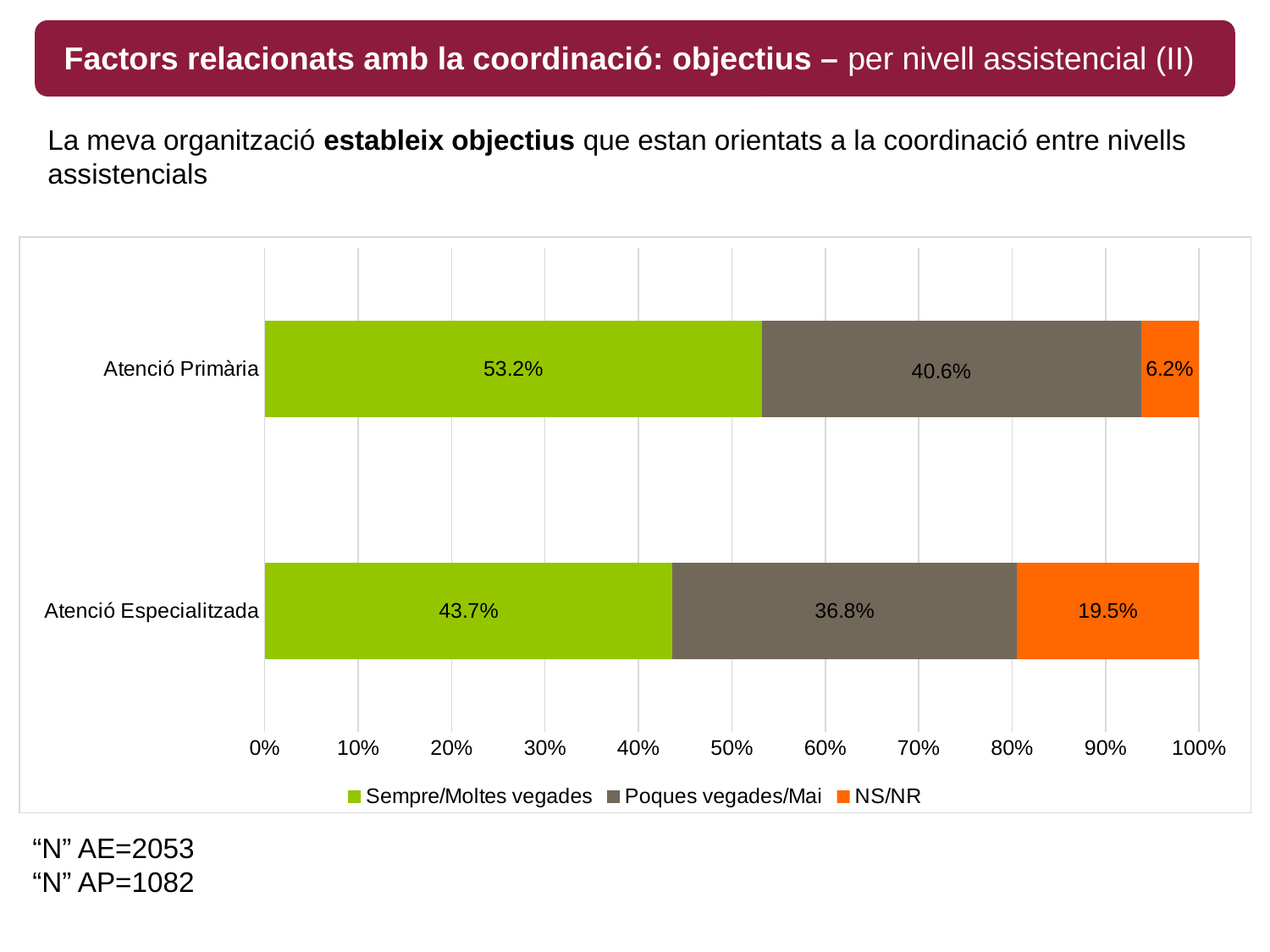
How many categories are shown on the chart? 2 What is the NS/NR value for Atenció Primària? 6.2% What is the value for Poques vegades/Mai for Atenció Especialitzada? 36.8% What is the difference between the Sempre/Moltes vegades values for Atenció Primària and Atenció Especialitzada? 9.5% Which category has the lower NS/NR value? Atenció Primària Which category has the higher value for Sempre/Moltes vegades? Atenció Primària What is the NS/NR value for Atenció Especialitzada? 19.5% What is the value for Sempre/Moltes vegades for Atenció Primària? 53.2% What colour represents the NS/NR series? Orange What kind of chart is shown on the slide? Stacked bar chart Is the Poques vegades/Mai value larger for Atenció Primària or Atenció Especialitzada? Atenció Primària How many series does the legend list? 3